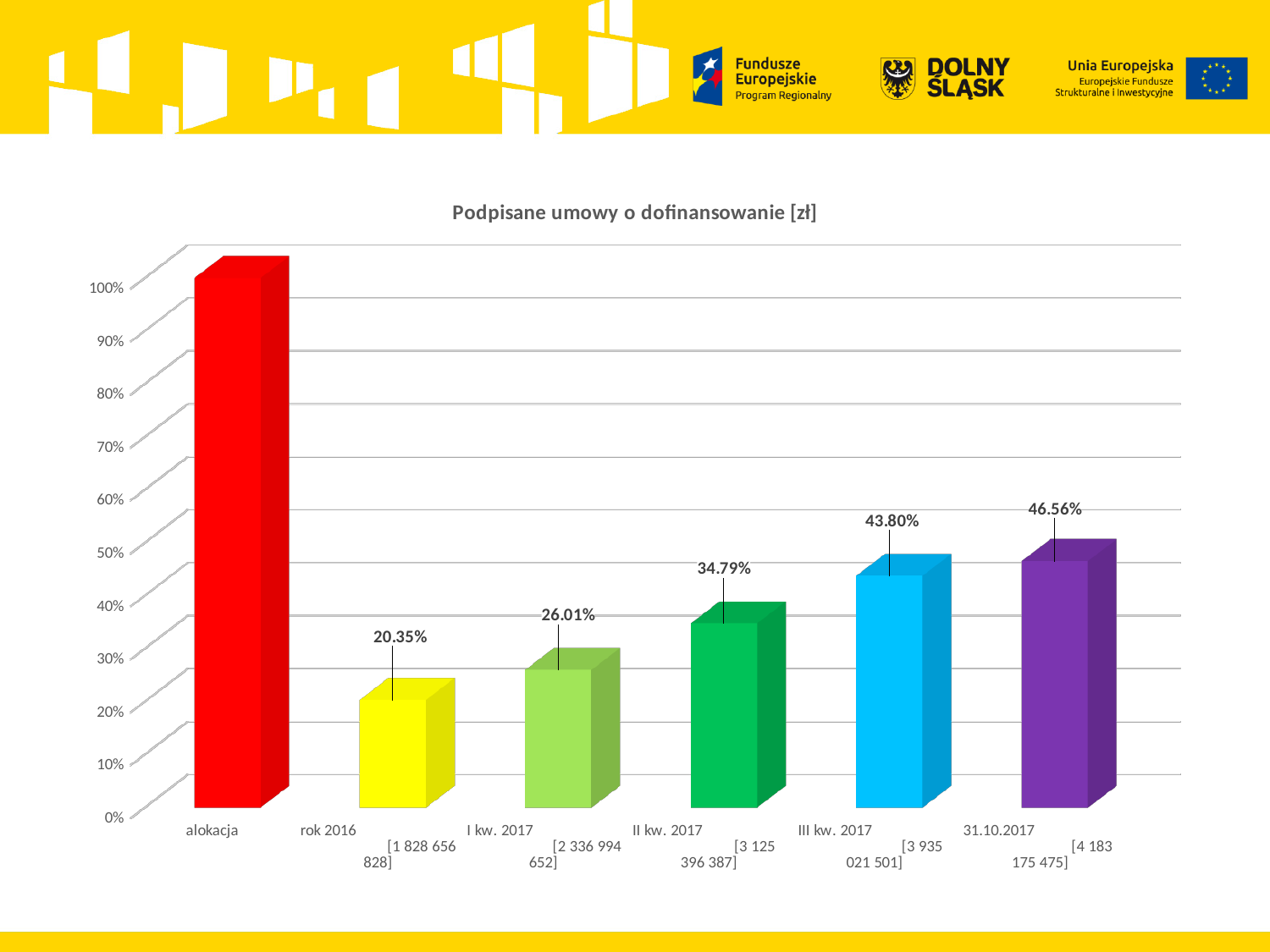
Which category has the lowest value in the chart? rok 2016 What is the title of the chart? Podpisane umowy o dofinansowanie [zł] Which category has the highest bar in the chart? alokacja What is the value shown for I kw. 2017? 26.01% What is the value shown for II kw. 2017? 34.79% How many bars are plotted in the chart? 6 What is the difference between the values for 31.10.2017 and III kw. 2017? 2.76% What is the value shown for rok 2016? 20.35% Do the values rise or fall from rok 2016 to 31.10.2017? rise What type of chart is shown on the slide? bar chart What is the value shown for III kw. 2017? 43.80% What is the value shown for 31.10.2017? 46.56%